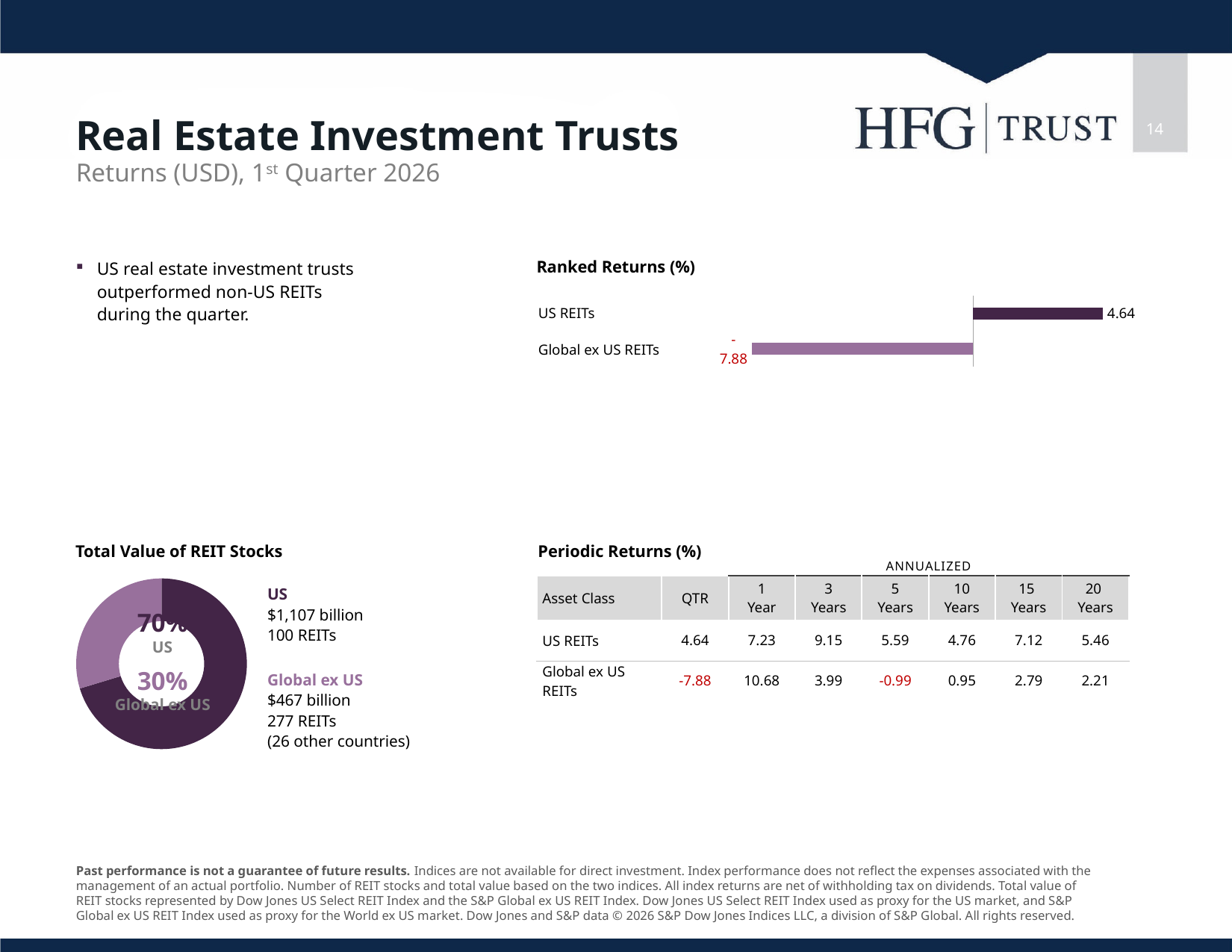
In the Ranked Returns (%) chart, which category has the lowest value? Global ex US REITs In the Ranked Returns (%) chart, what is the value for US REITs? 4.64 What kind of chart is the Ranked Returns (%) chart? Bar chart In the Total Value of REIT Stocks chart, which slice is larger, US or Global ex US? US In the Ranked Returns (%) chart, what is the difference between the US REITs value and the Global ex US REITs value? 12.52 In the Total Value of REIT Stocks chart, what share does US represent? 70% What kind of chart is the Total Value of REIT Stocks chart? Doughnut chart In the Ranked Returns (%) chart, what is the value for Global ex US REITs? -7.88 In the Total Value of REIT Stocks chart, what share does Global ex US represent? 30% In the Total Value of REIT Stocks chart, how many slices are shown? 2 In the Ranked Returns (%) chart, how many categories are plotted? 2 In the Ranked Returns (%) chart, which category has the highest value? US REITs